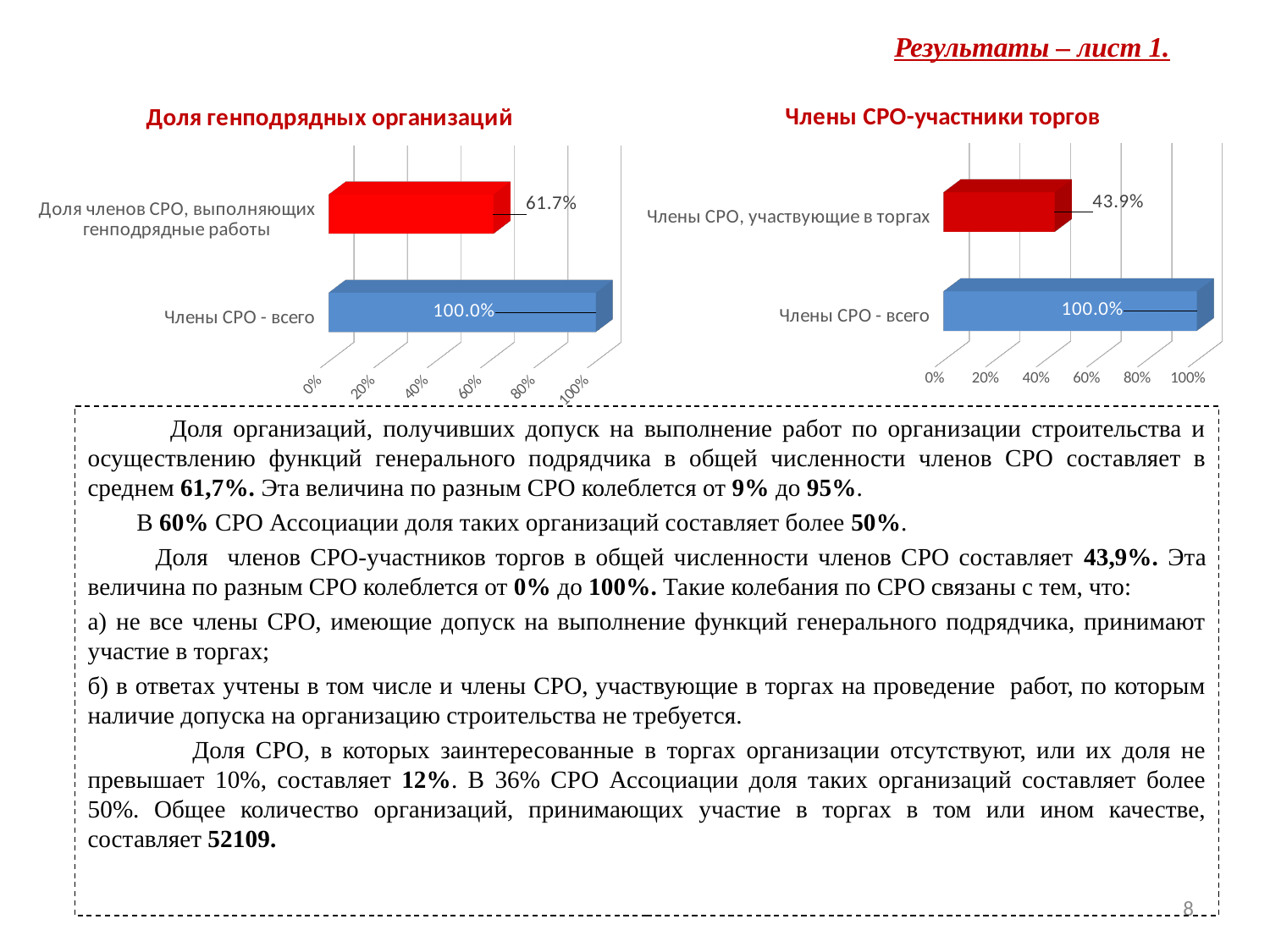
What type of chart is 'Члены СРО-участники торгов'? bar chart Is the value for 'Члены СРО, участвующие в торгах' in the right-hand chart greater or less than 60%? less In the chart 'Члены СРО-участники торгов', what is the value for 'Члены СРО - всего'? 100.0% In the chart 'Члены СРО-участники торгов', what is the difference between 'Члены СРО - всего' and 'Члены СРО, участвующие в торгах'? 56.1% In the chart 'Члены СРО-участники торгов', which category has the highest value? Члены СРО - всего In the chart 'Доля генподрядных организаций', what is the difference between 'Члены СРО - всего' and 'Доля членов СРО, выполняющих генподрядные работы'? 38.3% In the chart 'Члены СРО-участники торгов', what is the value for 'Члены СРО, участвующие в торгах'? 43.9% How many categories are shown in the chart 'Доля генподрядных организаций'? 2 In the chart 'Доля генподрядных организаций', which category has the lowest value? Доля членов СРО, выполняющих генподрядные работы In the chart 'Доля генподрядных организаций', what is the value for 'Доля членов СРО, выполняющих генподрядные работы'? 61.7% What is the title of the chart on the left side of the slide? Доля генподрядных организаций In the chart 'Доля генподрядных организаций', what is the value for 'Члены СРО - всего'? 100.0%